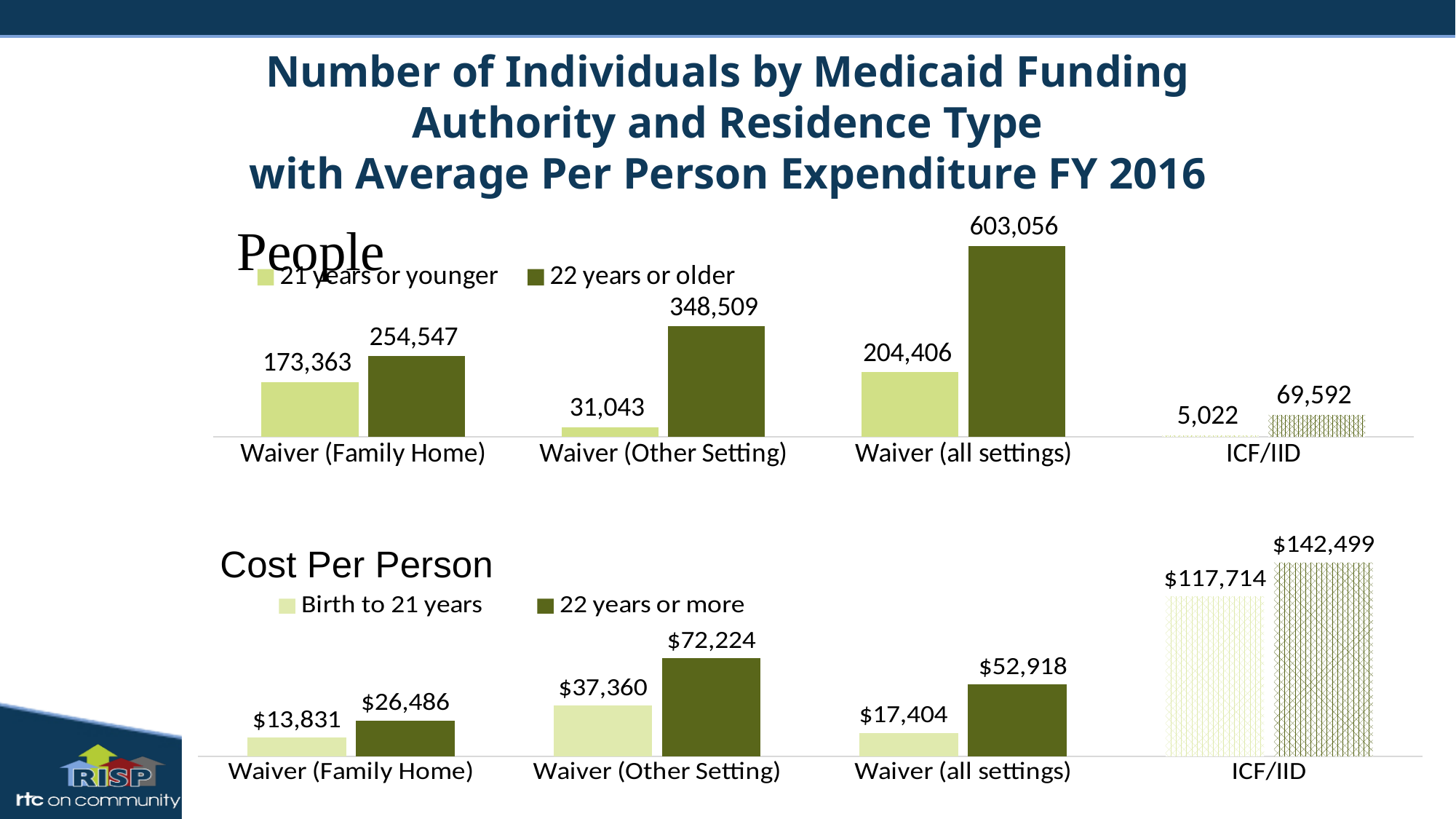
How many categories are shown on the x axis of the Cost Per Person chart? 4 In the People chart, what is the difference between the 22 years or older and 21 years or younger values for Waiver (Family Home)? 81,184 In the Cost Per Person chart, which category has the highest cost for Birth to 21 years? ICF/IID In the Cost Per Person chart, which is larger: the 22 years or more cost for Waiver (Other Setting) or for Waiver (all settings)? Waiver (Other Setting) What type of chart is the People chart? Bar chart In the Cost Per Person chart, what is the cost for 22 years or more in ICF/IID? $142,499 In the People chart, how many individuals 22 years or older are in Waiver (all settings)? 603,056 In the People chart, how many individuals 21 years or younger are in Waiver (Other Setting)? 31,043 In the Cost Per Person chart, what is the cost for Birth to 21 years in Waiver (all settings)? $17,404 In the People chart, how many series does the legend list? 2 In the Cost Per Person chart, what is the difference between the 22 years or more and Birth to 21 years costs for Waiver (Family Home)? $12,655 In the People chart, which category has the lowest value for 21 years or younger? ICF/IID